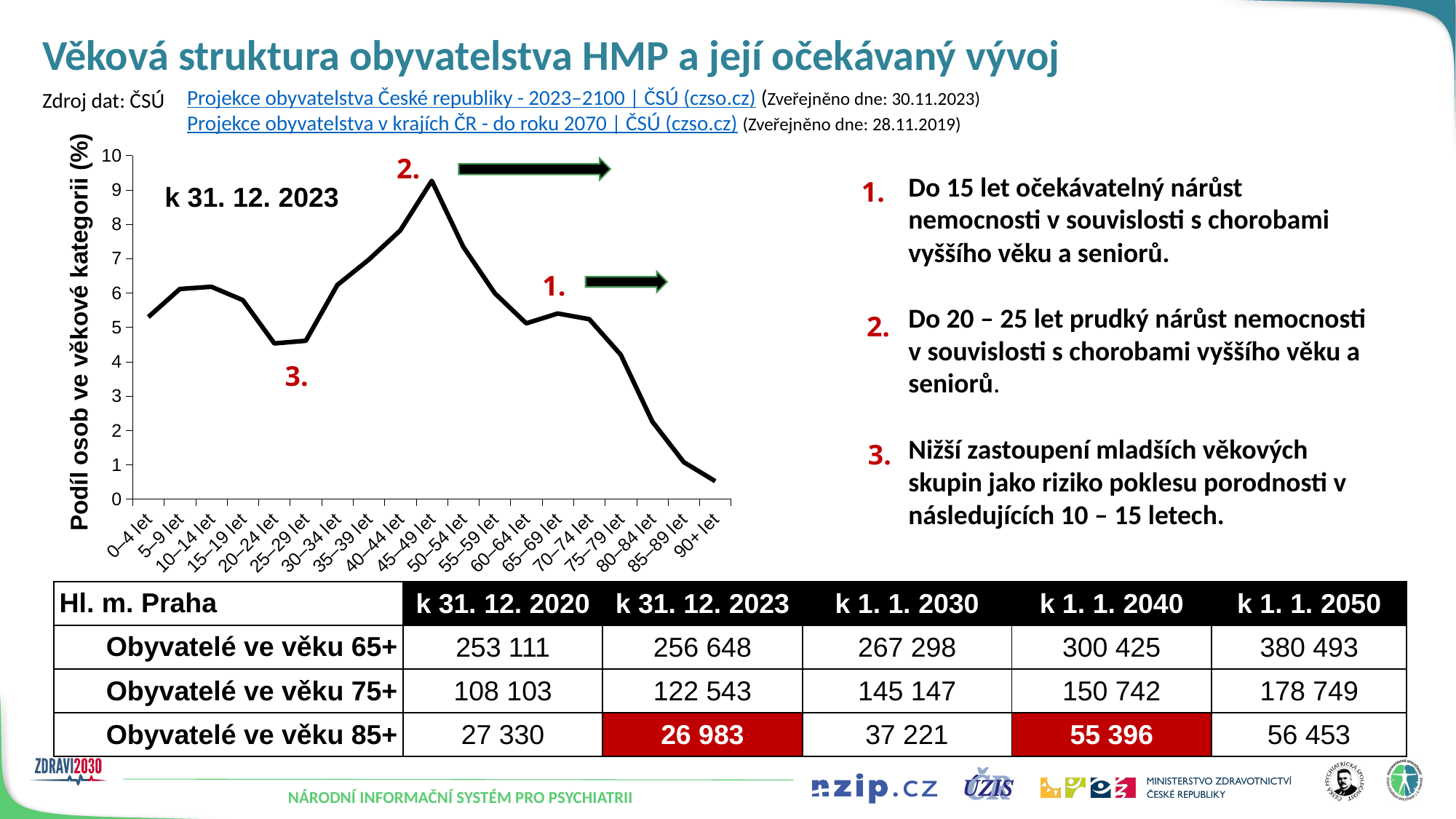
Which has a larger share, 45–49 let or 65–69 let? 45–49 let What is the label of the y axis of the chart? Podíl osob ve věkové kategorii (%) Is the value for 90+ let greater or less than 1? less Which has a larger share, 10–14 let or 20–24 let? 10–14 let Is the value for 45–49 let greater or less than 8? greater Which age category has the highest share in the chart? 45–49 let What kind of chart is shown on the slide? line chart Which age category has the lowest share in the chart? 90+ let Is the value for 80–84 let greater or less than 3? less How many age categories are shown on the x axis of the chart? 19